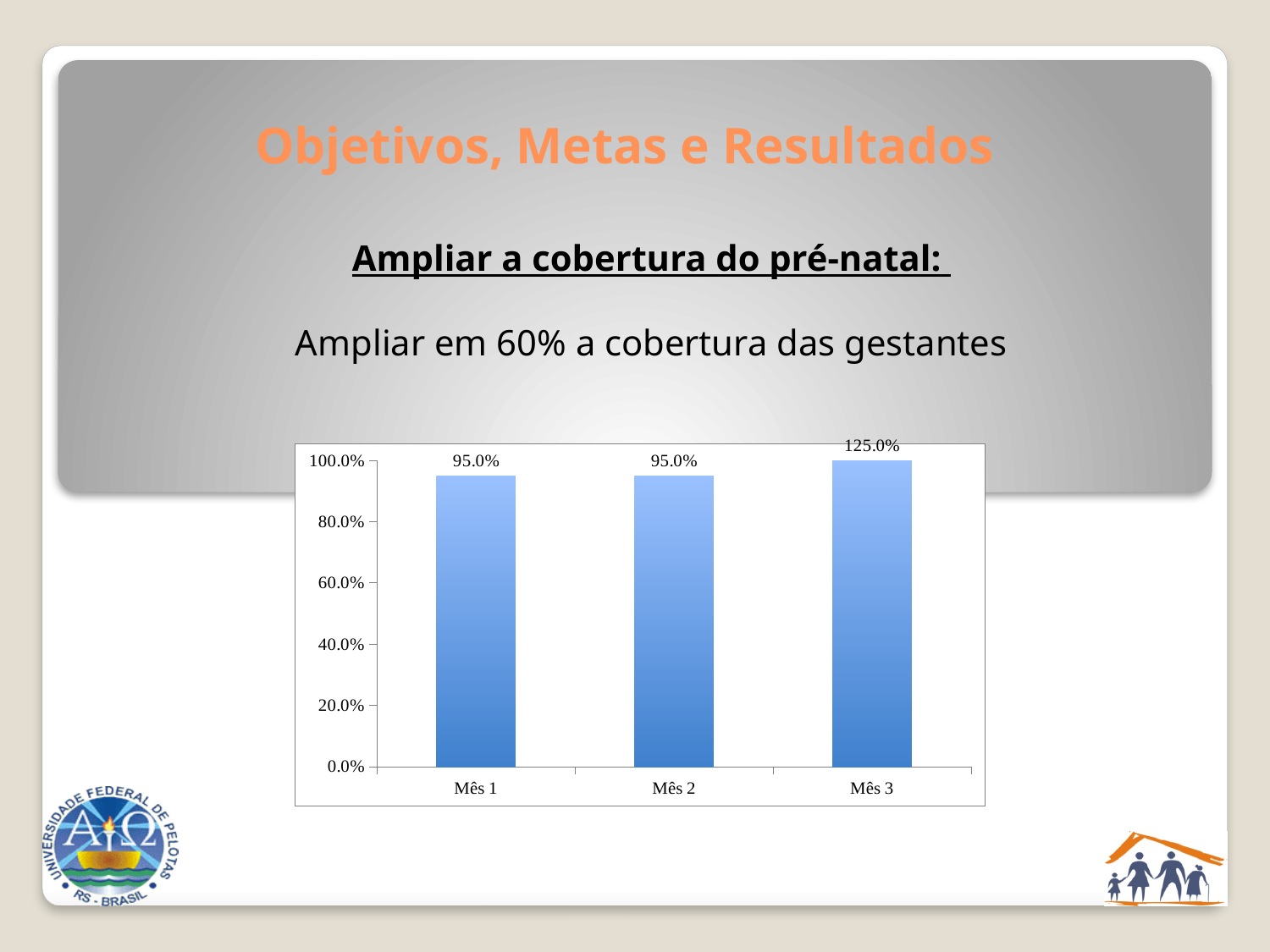
What is the value for Mês 3? 125.0% Is the value for Mês 2 greater or less than 60.0%? greater What is the value for Mês 2? 95.0% What is the difference between the values for Mês 3 and Mês 1? 30.0% Which is larger, the value for Mês 3 or the value for Mês 2? Mês 3 What is the value for Mês 1? 95.0% Is the value for Mês 1 greater or less than 80.0%? greater Which month has the highest value? Mês 3 How many categories are shown on the x axis? 3 Do the values rise or fall from Mês 1 to Mês 3? rise What is the highest tick label shown on the y axis? 100.0% What kind of chart is shown on the slide? bar chart